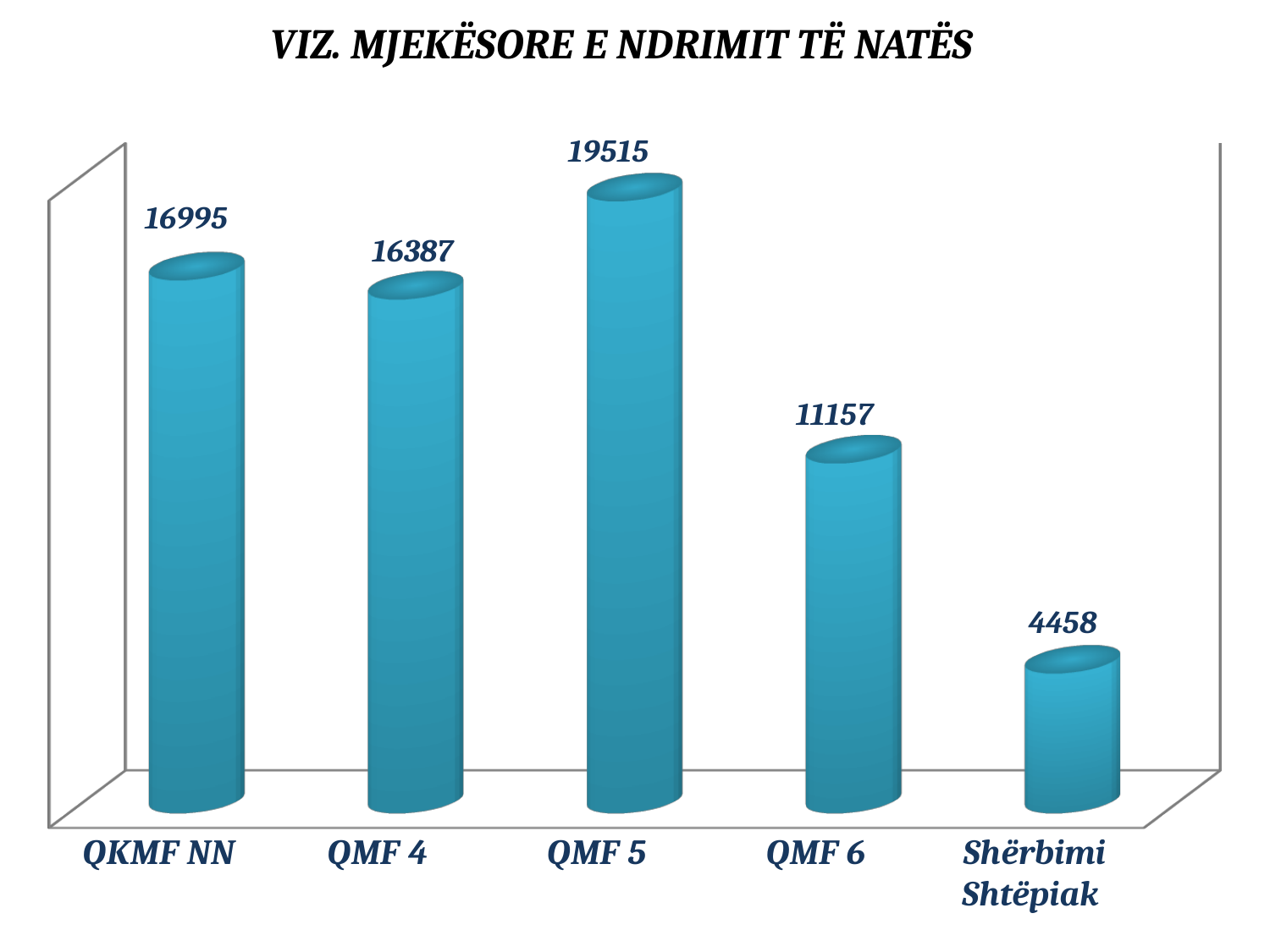
How many categories are shown in the chart? 5 What is the difference between the values for QKMF NN and QMF 4? 608 What is the value for QMF 4? 16387 What is the value for Shërbimi Shtëpiak? 4458 What is the value for QKMF NN? 16995 Which category has the highest value? QMF 5 What is the value for QMF 5? 19515 What is the difference between the values for QMF 5 and QMF 6? 8358 What is the value for QMF 6? 11157 Which category has the lowest value? Shërbimi Shtëpiak What kind of chart is shown on the slide? Bar chart Which is larger, the value for QMF 6 or the value for Shërbimi Shtëpiak? QMF 6